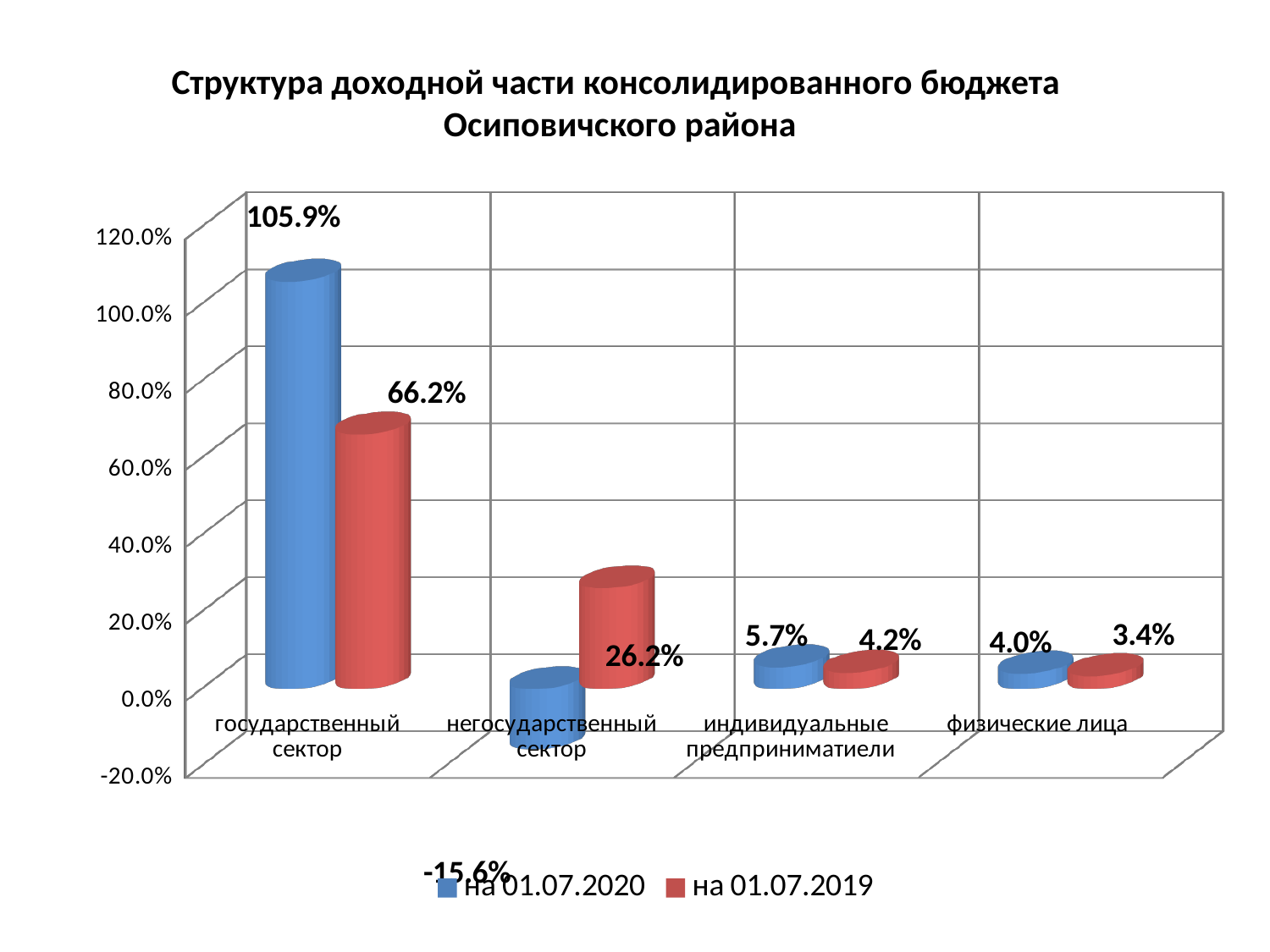
What is the value for негосударственный сектор in the series на 01.07.2019? 26.2% What is the value for государственный сектор in the series на 01.07.2019? 66.2% What kind of chart is shown on the slide? bar chart What is the difference between the на 01.07.2020 and на 01.07.2019 values for государственный сектор? 39.7% Which category has the lowest value in the series на 01.07.2019? физические лица What is the value for физические лица in the series на 01.07.2019? 3.4% How many series does the legend list? 2 What is the value for индивидуальные предприниматиели in the series на 01.07.2020? 5.7% What is the value for государственный сектор in the series на 01.07.2020? 105.9% How many categories are shown on the x axis? 4 For негосударственный сектор, which series has the larger value: на 01.07.2020 or на 01.07.2019? на 01.07.2019 Which category has the highest value in the series на 01.07.2020? государственный сектор